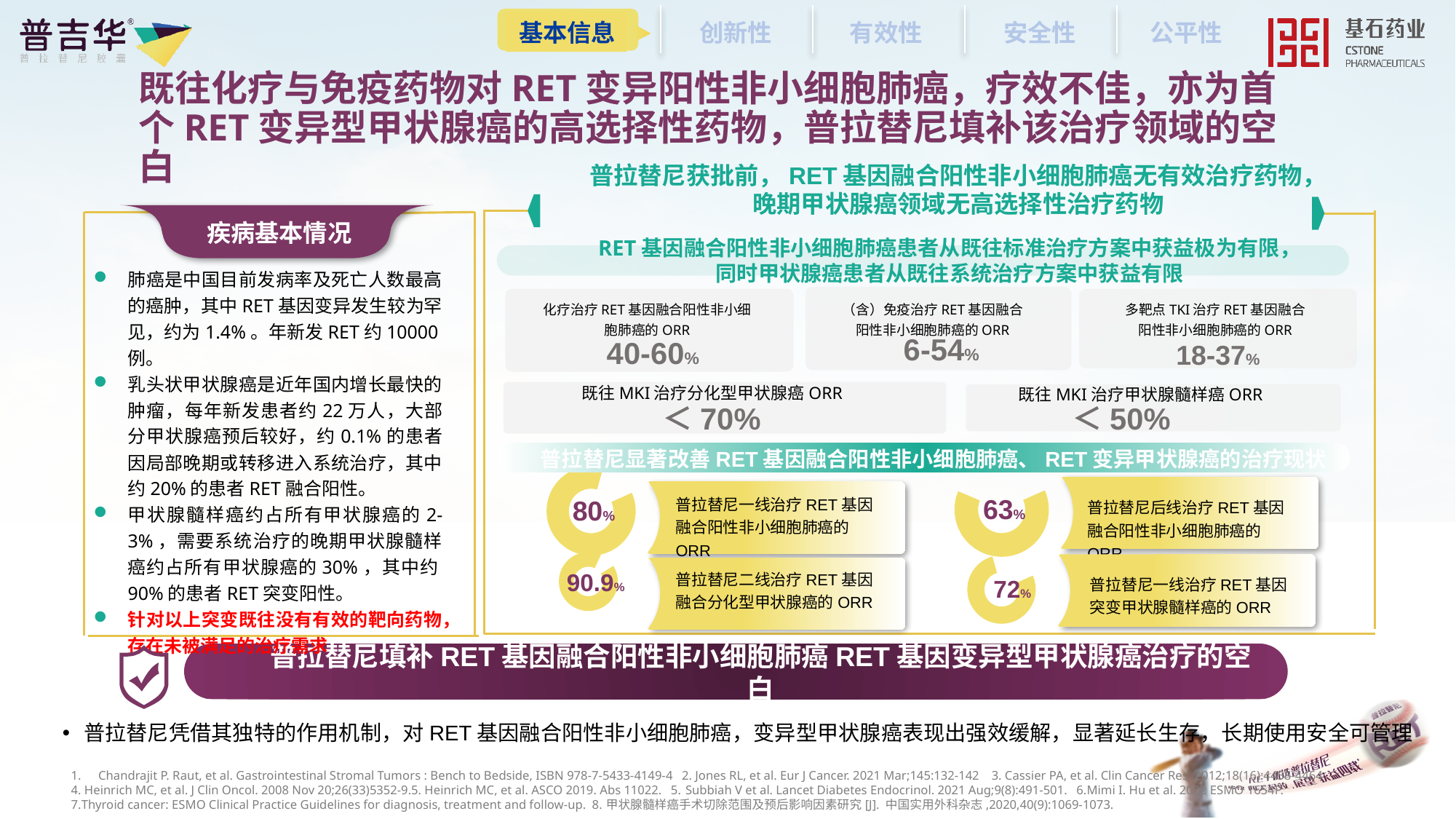
What ORR value is shown in the donut chart for 普拉替尼后线治疗 RET 基因融合阳性非小细胞肺癌? 63% What colour are the rings of the ORR donut charts on the slide? Yellow Among the four donut charts in the lower section of the slide, which treatment setting has the lowest ORR? 普拉替尼后线治疗 RET 基因融合阳性非小细胞肺癌 What kind of chart is used to display the ORR values in the lower section of the slide? Donut chart What ORR value is shown in the donut chart for 普拉替尼一线治疗 RET 基因融合阳性非小细胞肺癌? 80% What is the difference between the ORR for 普拉替尼二线治疗 RET 基因融合分化型甲状腺癌 and the ORR for 普拉替尼一线治疗 RET 突变甲状腺髓样癌? 18.9% Which is larger: the ORR for 普拉替尼一线治疗 RET 基因融合阳性非小细胞肺癌 or the ORR for 普拉替尼一线治疗 RET 突变甲状腺髓样癌? 普拉替尼一线治疗 RET 基因融合阳性非小细胞肺癌 How many donut charts showing ORR values are in the lower section of the slide? 4 Among the four donut charts in the lower section of the slide, which treatment setting has the highest ORR? 普拉替尼二线治疗 RET 基因融合分化型甲状腺癌 What ORR value is shown in the donut chart for 普拉替尼一线治疗 RET 突变甲状腺髓样癌? 72% What is the difference between the ORR for 普拉替尼一线治疗 RET 基因融合阳性非小细胞肺癌 and the ORR for 普拉替尼后线治疗 RET 基因融合阳性非小细胞肺癌? 17% What ORR value is shown in the donut chart for 普拉替尼二线治疗 RET 基因融合分化型甲状腺癌? 90.9%